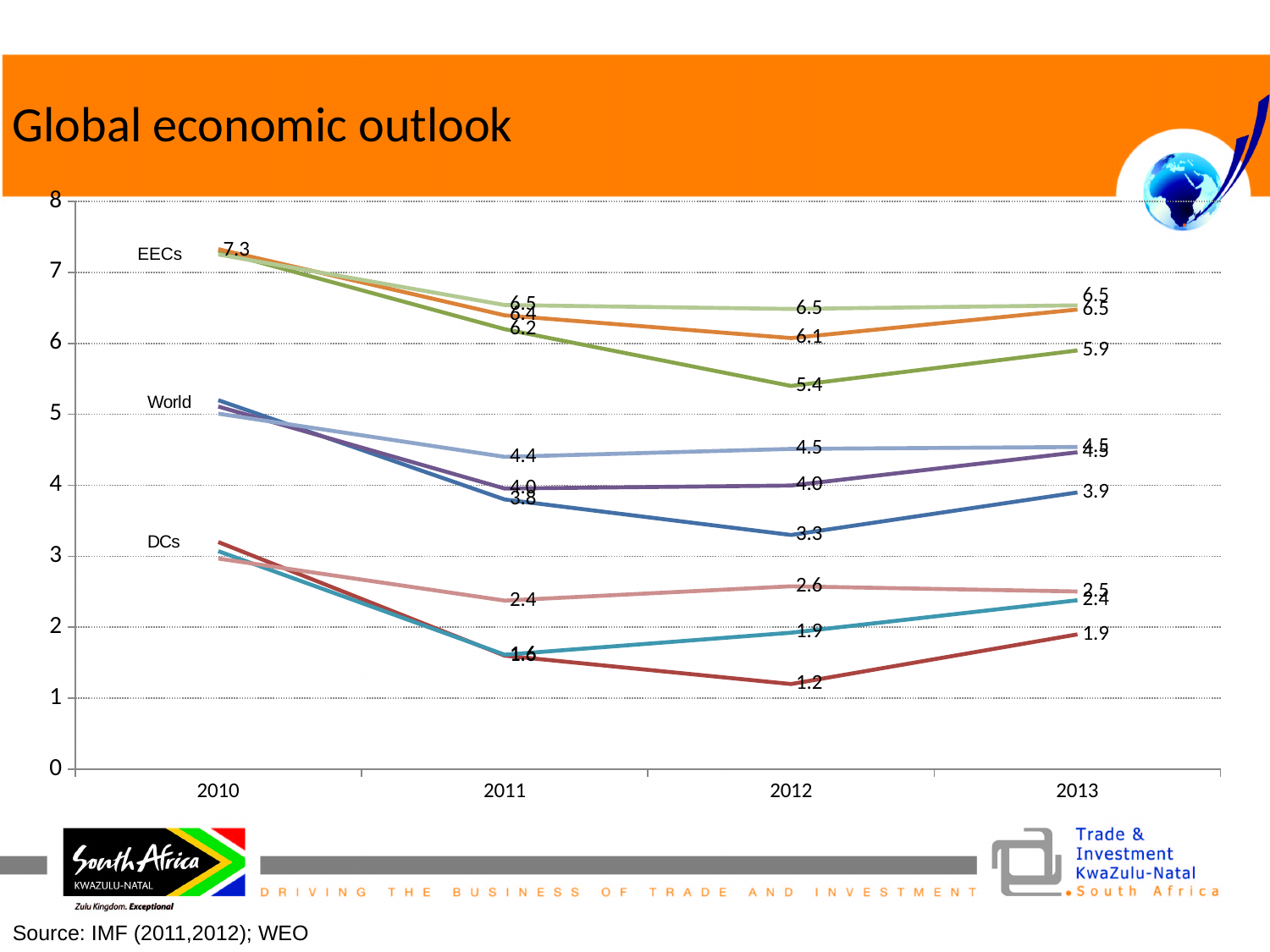
What is the highest value plotted in 2010? 7.3 Does the lowest EECs line rise or fall from 2010 to 2012? fall What is the lowest value plotted in 2012? 1.2 Which is larger in 2012: the lowest World line value or the lowest DCs line value? the lowest World line value What is the lowest value among the EECs lines in 2012? 5.4 What is the title of the chart? Global economic outlook What is the lowest value among the World lines in 2012? 3.3 Is the lowest DCs line value in 2012 greater or less than 2? less What is the difference between the highest and lowest EECs values in 2012? 1.1 How many years are shown on the x axis of the chart? 4 What kind of chart is shown on the slide? line chart What is the highest value among the EECs lines in 2012? 6.5